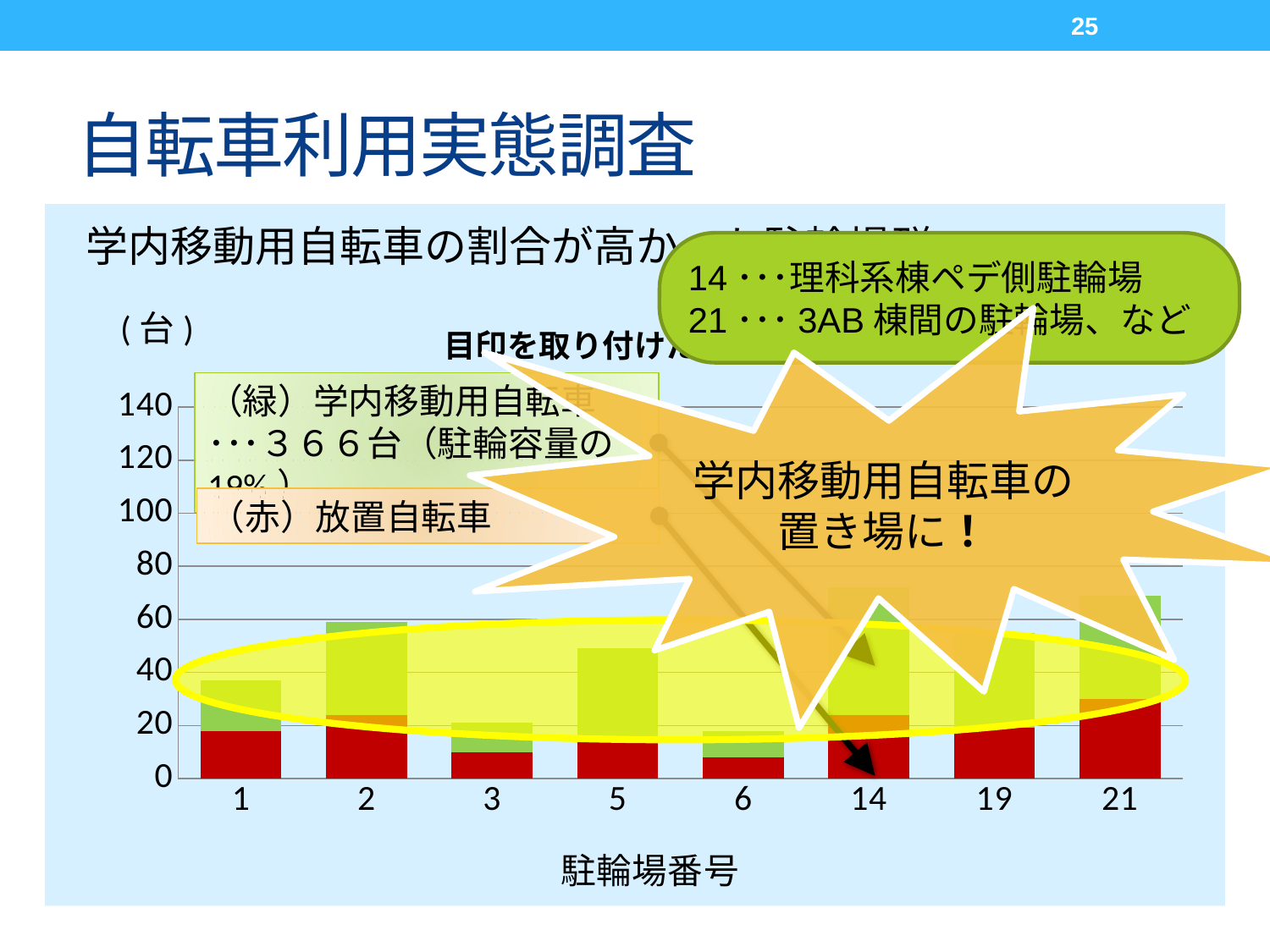
Which stacked bar is taller overall: parking lot 5 or parking lot 3? 5 Is the total height of the stacked bar for parking lot 5 greater or less than 40? greater Is the red (放置自転車) value for parking lot 3 greater or less than 20? less What is the x-axis title of the chart? 駐輪場番号 Is the total height of the stacked bar for parking lot 21 greater or less than 60? greater What kind of chart is shown on the slide? bar chart According to the slide, what does the red part of each bar represent? 放置自転車 Which has the larger red (放置自転車) value: parking lot 21 or parking lot 3? 21 How many parking lot numbers (駐輪場番号) are shown on the x axis of the chart? 8